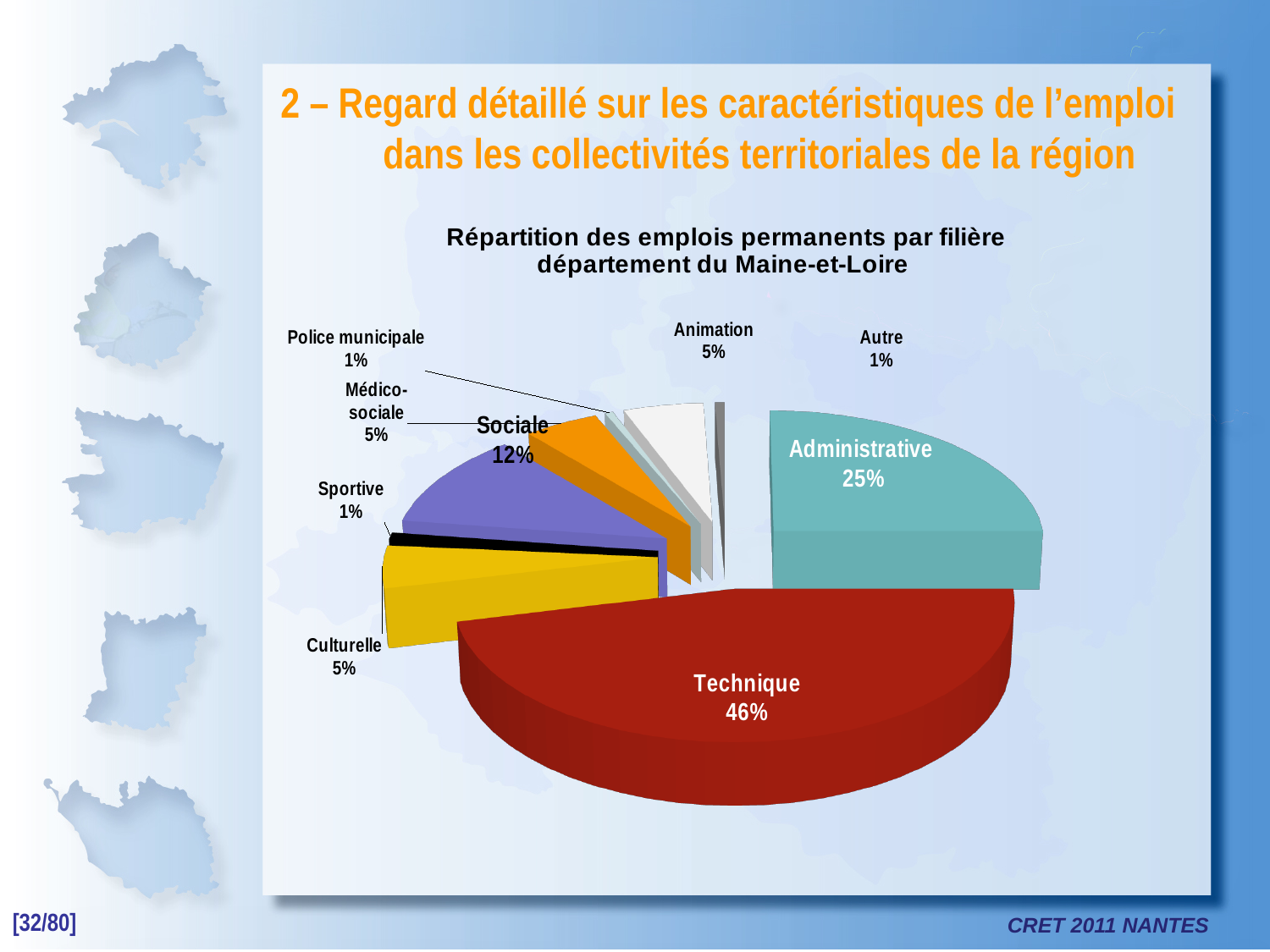
What is the difference in percentage points between the Sociale and Animation slices? 7 Which département does the chart title say the data is for? Maine-et-Loire What kind of chart is shown on the slide? Pie chart What is the difference in percentage points between the Technique and Administrative slices? 21 What colour is the Technique slice? Red Which slice is larger, Sociale or Culturelle? Sociale What percentage is shown for the Administrative slice? 25% What percentage is shown for the Médico-sociale slice? 5% How many categories (slices) does the pie chart show? 9 Which filière has the largest share of the pie? Technique What percentage is shown for the Sociale slice? 12% What share of permanent jobs does the Technique filière represent? 46%